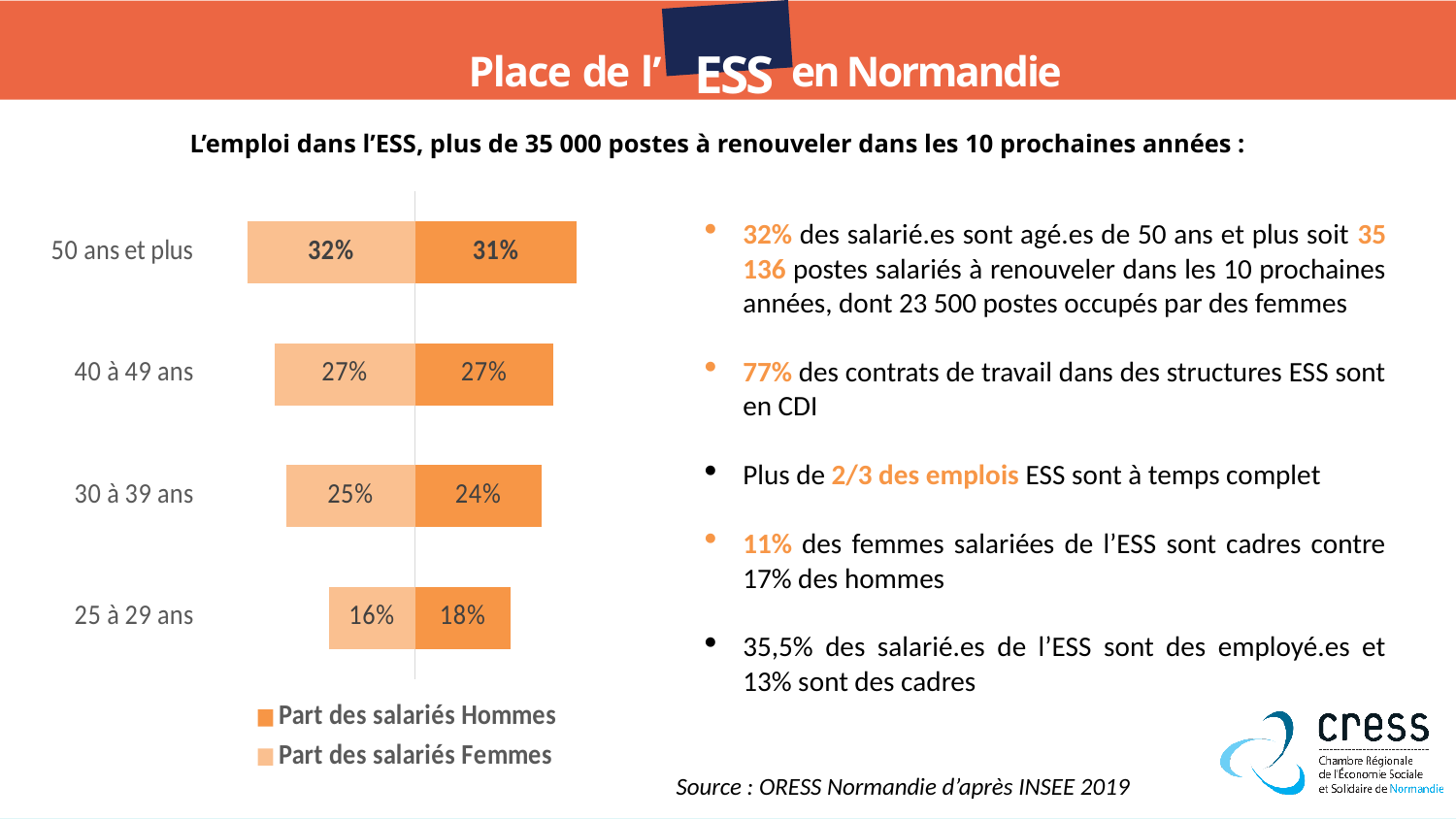
Which age category has the highest value for 'Part des salariés Femmes'? 50 ans et plus What is the value of 'Part des salariés Hommes' for '25 à 29 ans'? 18% What is the value of 'Part des salariés Hommes' for '50 ans et plus'? 31% For '25 à 29 ans', which is larger: 'Part des salariés Hommes' or 'Part des salariés Femmes'? Part des salariés Hommes What is the difference between 'Part des salariés Hommes' and 'Part des salariés Femmes' for '25 à 29 ans'? 2% What kind of chart is shown on the slide? bar chart What is the value of 'Part des salariés Femmes' for '30 à 39 ans'? 25% How many series does the chart legend list? 2 Which legend entry is shown in the darker orange colour? Part des salariés Hommes Which age category has the lowest value for 'Part des salariés Hommes'? 25 à 29 ans How many age categories are shown in the chart? 4 What is the value of 'Part des salariés Femmes' for '50 ans et plus'? 32%